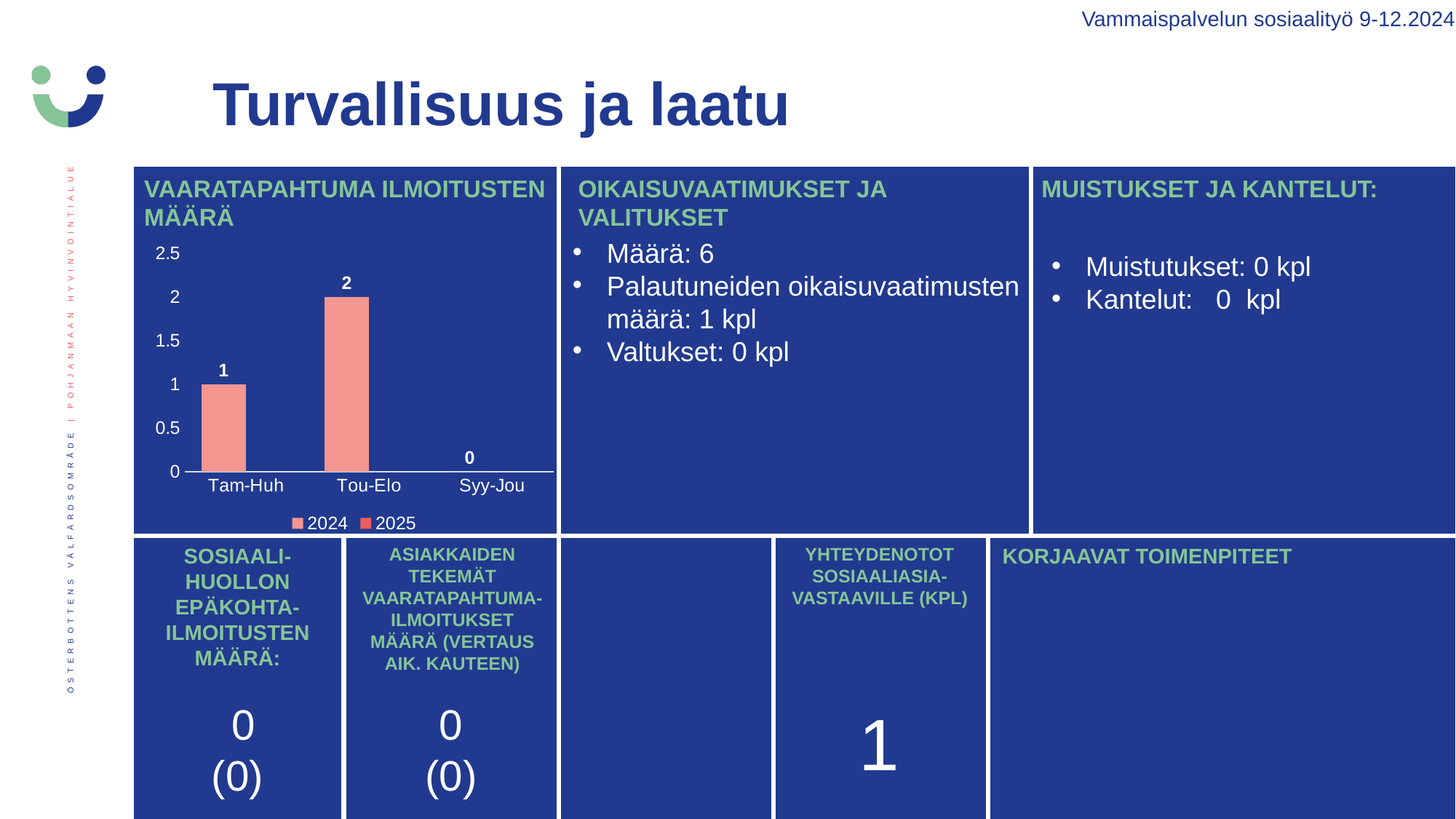
What are the two series named in the legend of the VAARATAPAHTUMA ILMOITUSTEN MÄÄRÄ chart? 2024 and 2025 What is the difference between the values for Tou-Elo and Tam-Huh in the VAARATAPAHTUMA ILMOITUSTEN MÄÄRÄ chart? 1 Which category has the lowest value in the VAARATAPAHTUMA ILMOITUSTEN MÄÄRÄ chart? Syy-Jou What is the value for Syy-Jou in the VAARATAPAHTUMA ILMOITUSTEN MÄÄRÄ chart? 0 What is the value for Tam-Huh in the VAARATAPAHTUMA ILMOITUSTEN MÄÄRÄ chart? 1 What is the value for Tou-Elo in the VAARATAPAHTUMA ILMOITUSTEN MÄÄRÄ chart? 2 Which is larger in the VAARATAPAHTUMA ILMOITUSTEN MÄÄRÄ chart, the value for Tam-Huh or Tou-Elo? Tou-Elo Is the value for Tou-Elo in the VAARATAPAHTUMA ILMOITUSTEN MÄÄRÄ chart greater or less than 1.5? greater What kind of chart is the VAARATAPAHTUMA ILMOITUSTEN MÄÄRÄ chart? bar chart How many categories are shown on the x axis of the VAARATAPAHTUMA ILMOITUSTEN MÄÄRÄ chart? 3 How many series does the legend of the VAARATAPAHTUMA ILMOITUSTEN MÄÄRÄ chart list? 2 Which category has the highest value in the VAARATAPAHTUMA ILMOITUSTEN MÄÄRÄ chart? Tou-Elo